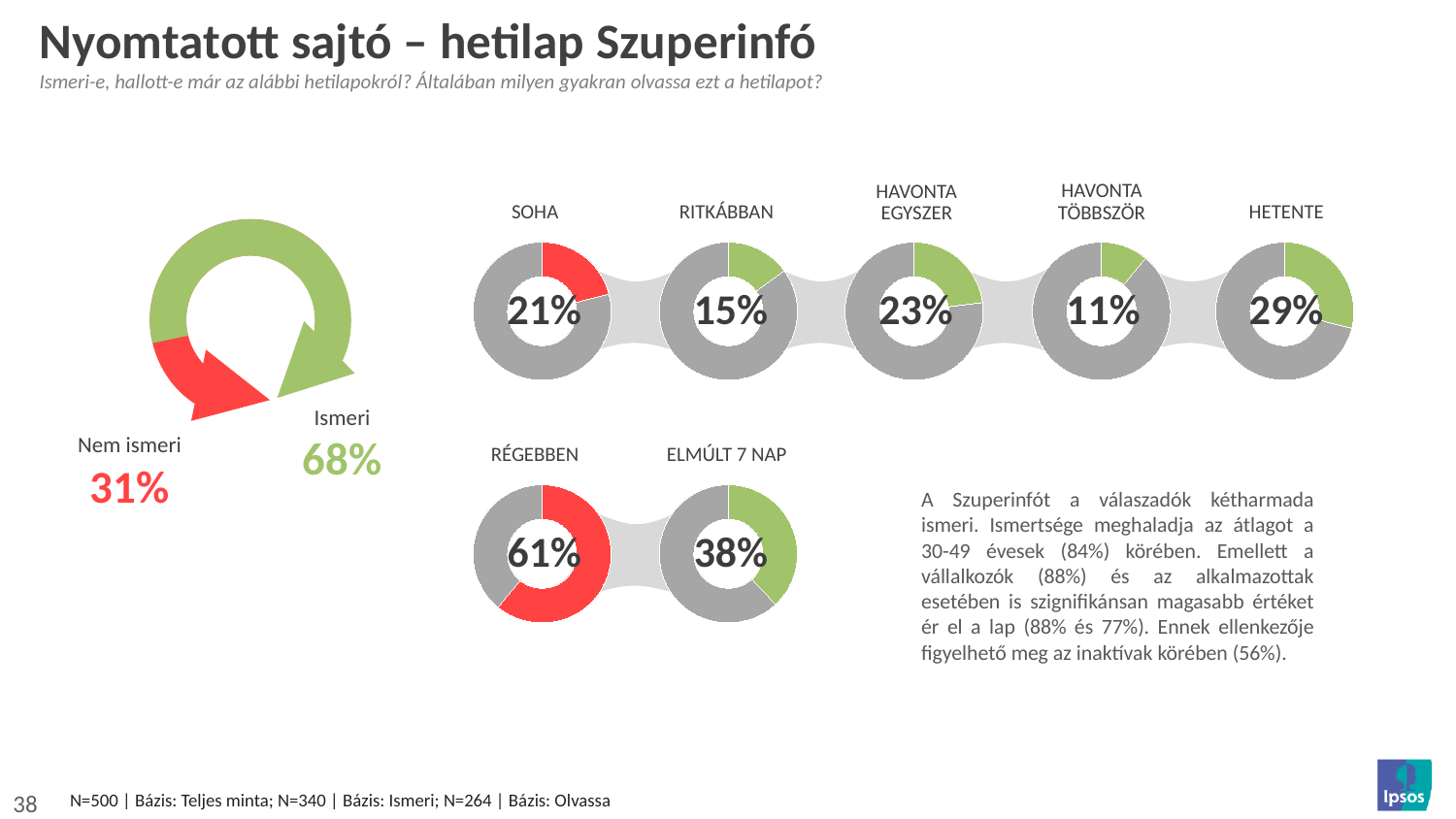
In the pair of donut charts in the lower middle, what value is shown for "RÉGEBBEN"? 61% In the row of five small donut charts at the top, what value is shown for "SOHA"? 21% In the row of five small donut charts at the top, what is the difference between the values for "HETENTE" and "RITKÁBBAN"? 14 percentage points In the row of five small donut charts at the top, which category has the lowest value? HAVONTA TÖBBSZÖR In the row of five small donut charts at the top, which is larger: the value for "HAVONTA EGYSZER" or the value for "SOHA"? HAVONTA EGYSZER In the large donut chart on the left, what percentage is shown for "Ismeri"? 68% How many small donut charts are in the top row of reading-frequency charts? 5 In the large donut chart on the left, what colour is the "Nem ismeri" segment? Red In the row of five small donut charts at the top, what value is shown for "HAVONTA TÖBBSZÖR"? 11% In the row of five small donut charts at the top, which category has the highest value? HETENTE In the large donut chart on the left, what percentage is shown for "Nem ismeri"? 31% In the pair of donut charts in the lower middle, what value is shown for "ELMÚLT 7 NAP"? 38%